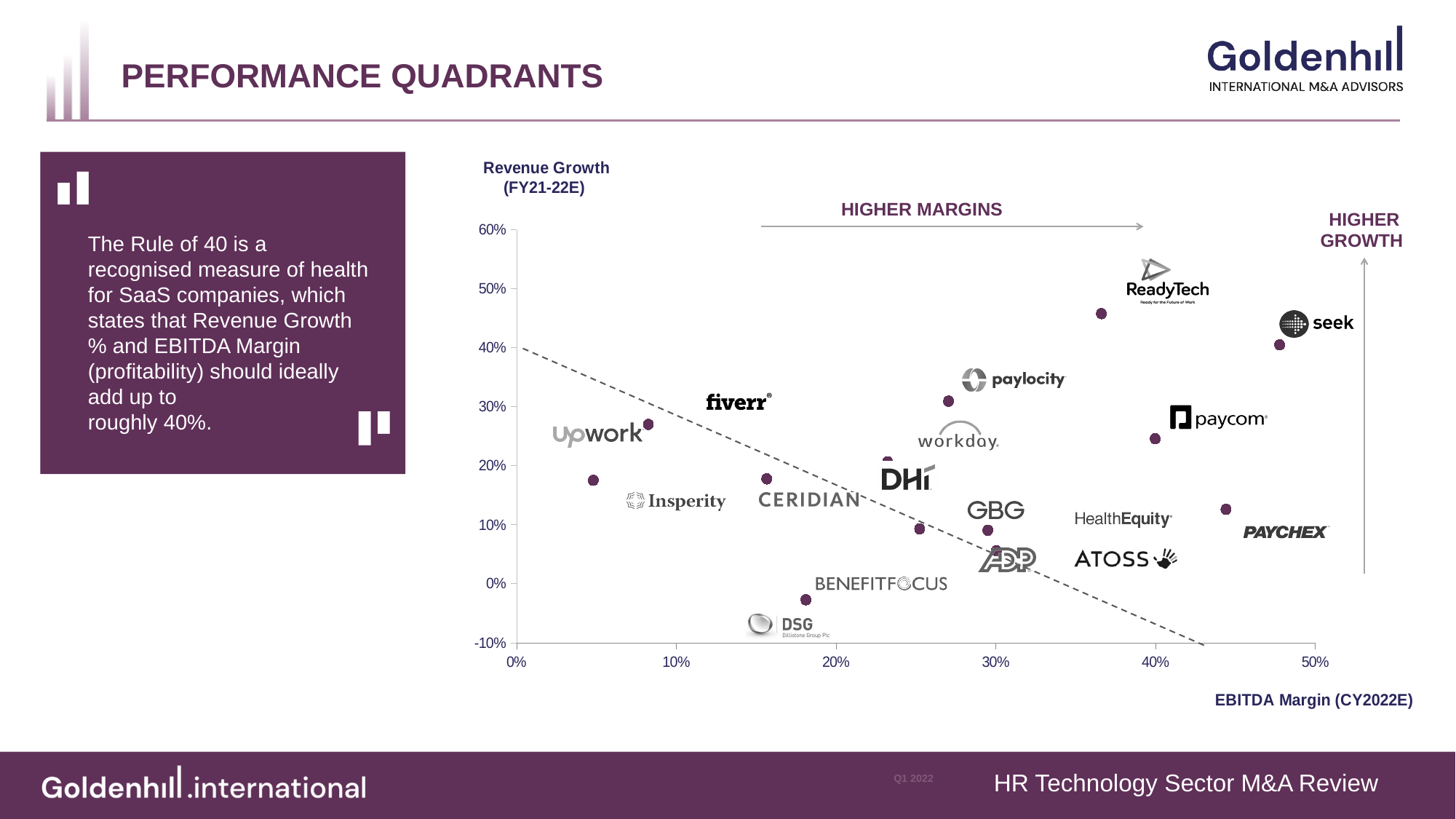
Which company has the highest EBITDA margin on the chart? seek Is the revenue growth for Paychex greater or less than 20%? less Is the EBITDA margin for Paylocity greater or less than 30%? less What is the label of the horizontal axis of the chart? EBITDA Margin (CY2022E) Which company has the highest revenue growth on the chart? ReadyTech Is the revenue growth for ReadyTech greater or less than 40%? greater Which has the higher revenue growth, ReadyTech or seek? ReadyTech What kind of chart is shown on the slide? scatter chart Which has the higher revenue growth, Paycom or Paychex? Paycom What is the label of the vertical axis of the chart? Revenue Growth (FY21-22E)